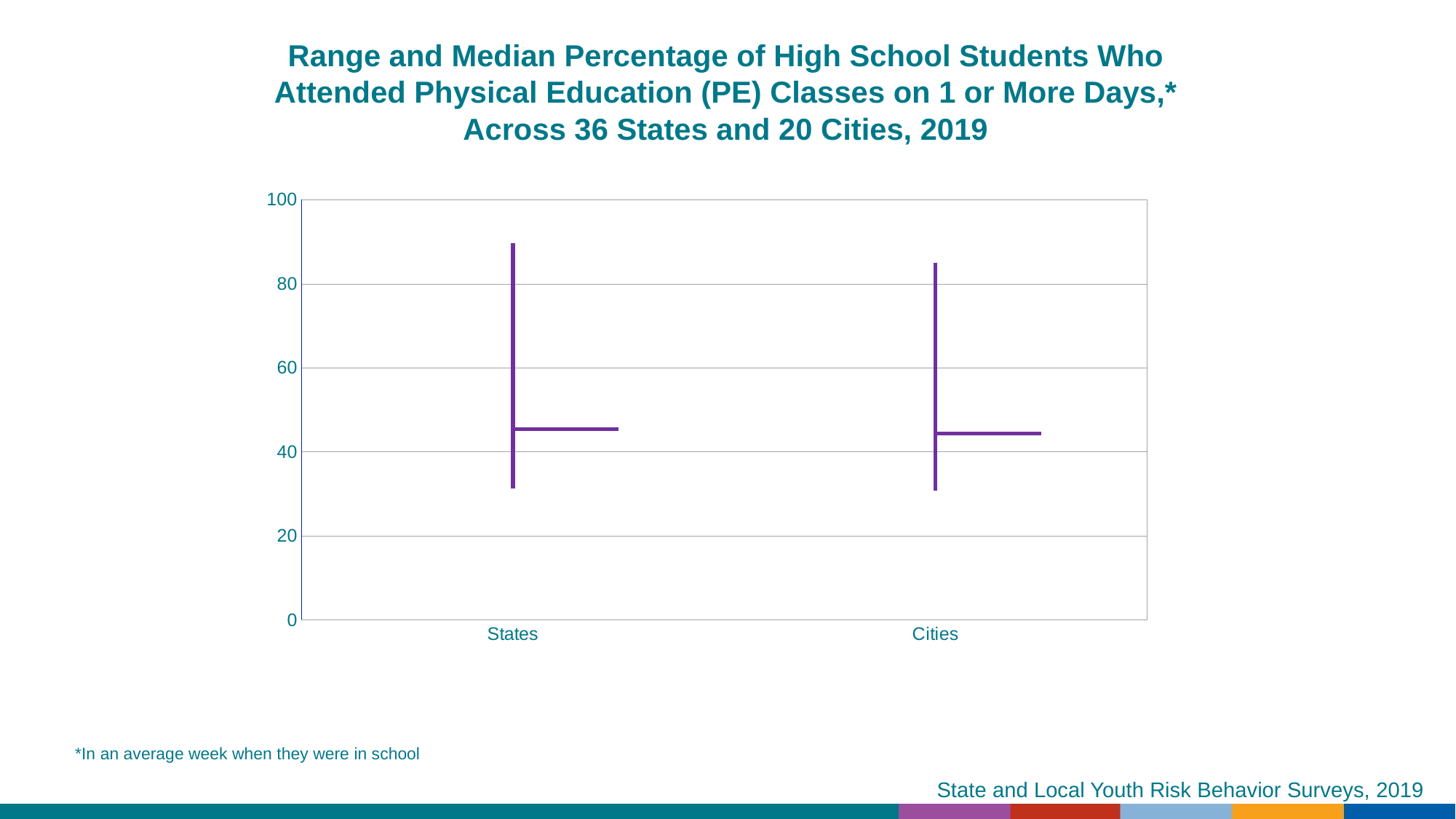
Is the median for States greater or less than 40? greater What are the two categories shown on the x axis? States and Cities Is the top of the range for Cities greater or less than 80? greater Is the median for Cities greater or less than 60? less How many categories are shown on the x axis of the chart? 2 Which category has the higher top of its range, States or Cities? States What year does the chart title say the data are from? 2019 What is the highest value shown on the y axis of the chart? 100